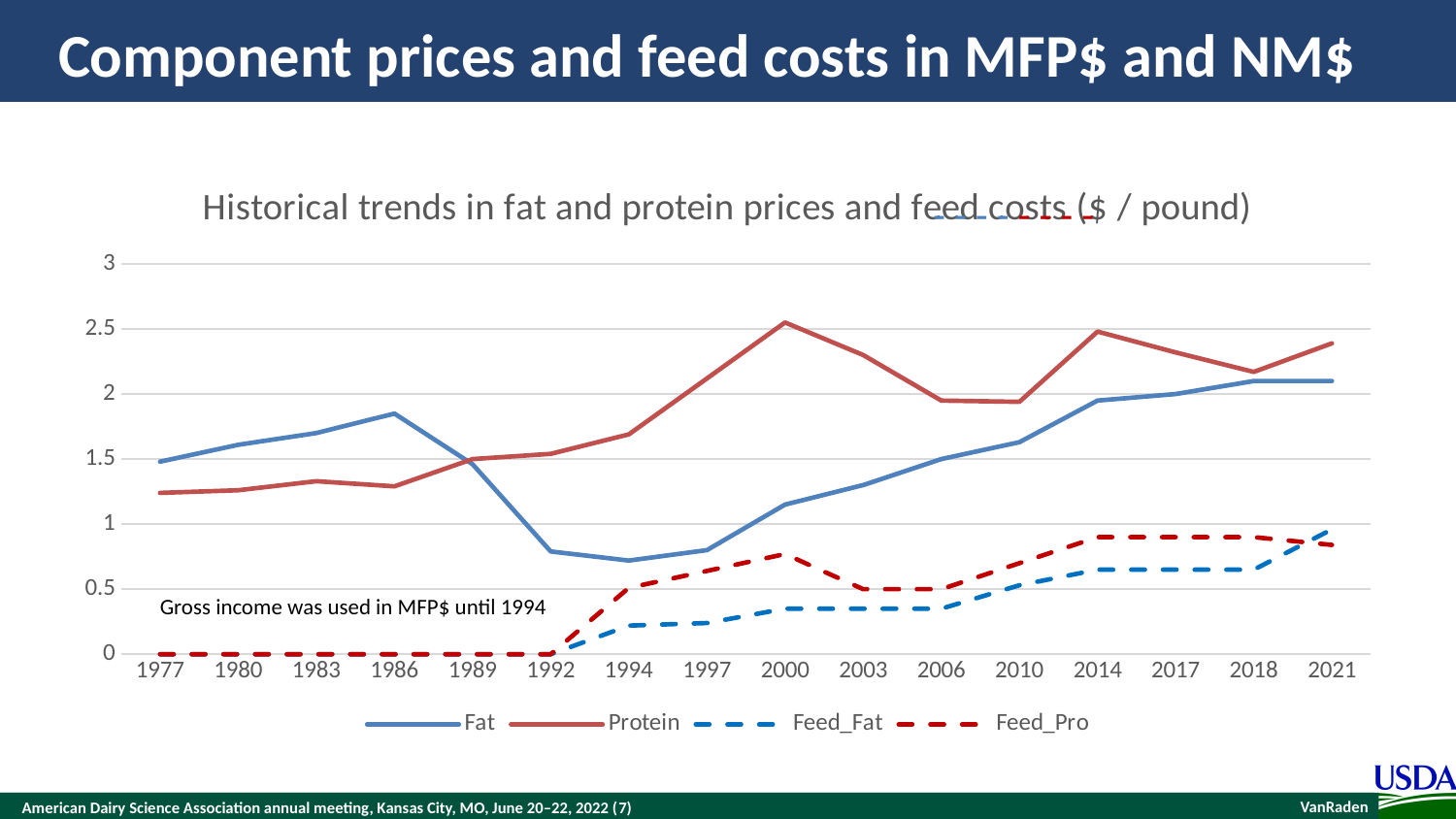
Does the Fat line rise or fall from 1992 to 2021? rise How many series does the chart legend list? 4 Is the value for Feed_Fat in 2006 greater or less than 0.5? less Is the value for Feed_Pro in 2014 greater or less than 0.5? greater In 1986, which is larger, the Fat value or the Protein value? Fat What is the value of Feed_Pro in 1992? 0 Is the value for Fat in 1994 greater or less than 1? less What kind of chart is shown on the slide? line chart How many years are labelled along the x axis of the chart? 16 In 2000, which is larger, the Fat value or the Protein value? Protein What is the value of Feed_Fat in 1977? 0